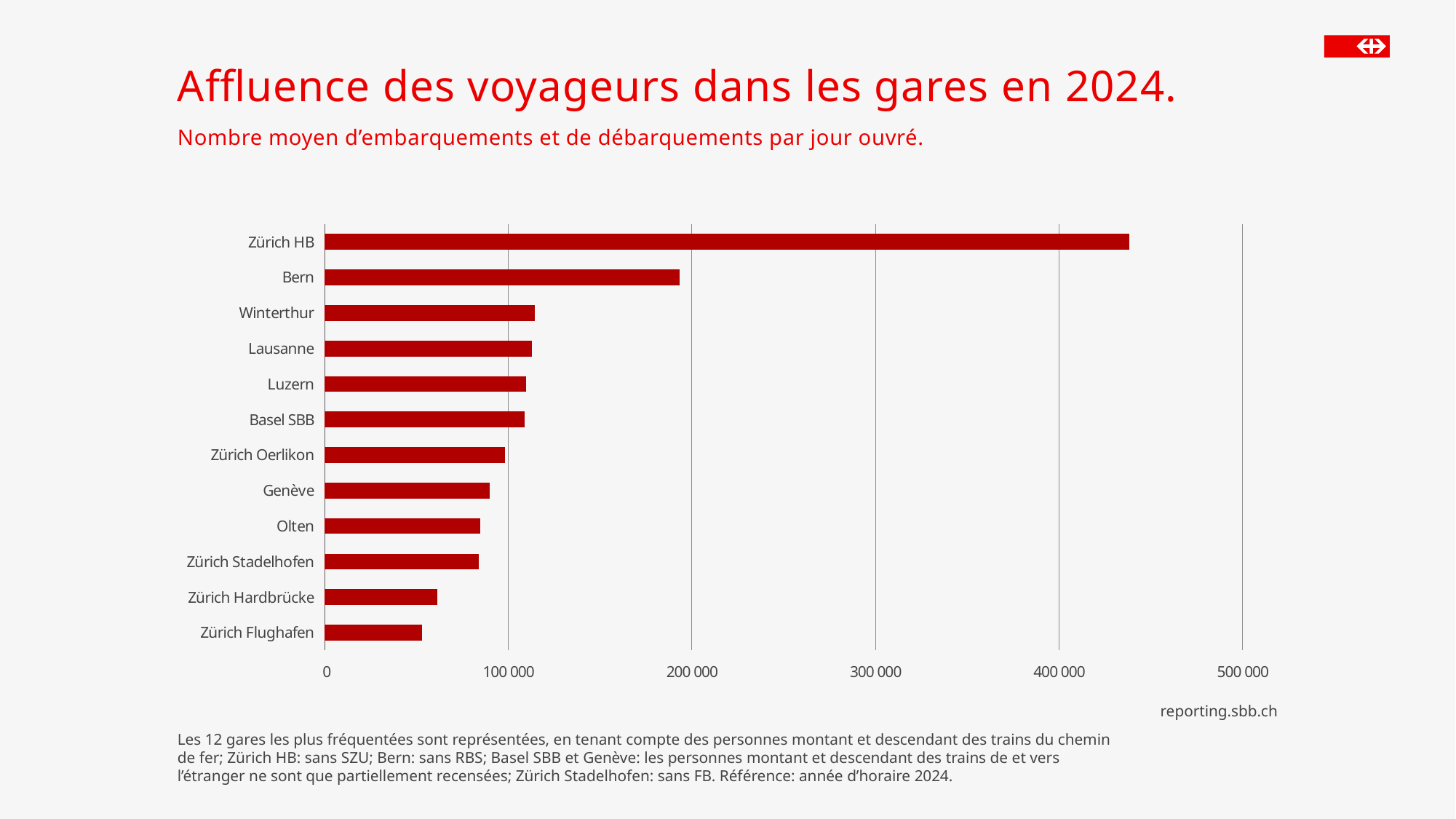
Which station has the lowest value in the chart? Zürich Flughafen Which has a larger value, Bern or Winterthur? Bern What kind of chart is shown on the slide? bar chart Is the value for Zürich HB greater or less than 400 000? greater Is the value for Bern greater or less than 200 000? less What is the title of the chart on the slide? Affluence des voyageurs dans les gares en 2024. Is the value for Winterthur greater or less than 100 000? greater Which station has the highest value in the chart? Zürich HB Which has a larger value, Zürich Hardbrücke or Zürich Flughafen? Zürich Hardbrücke How many stations are shown in the chart? 12 What is the highest value shown on the horizontal axis? 500 000